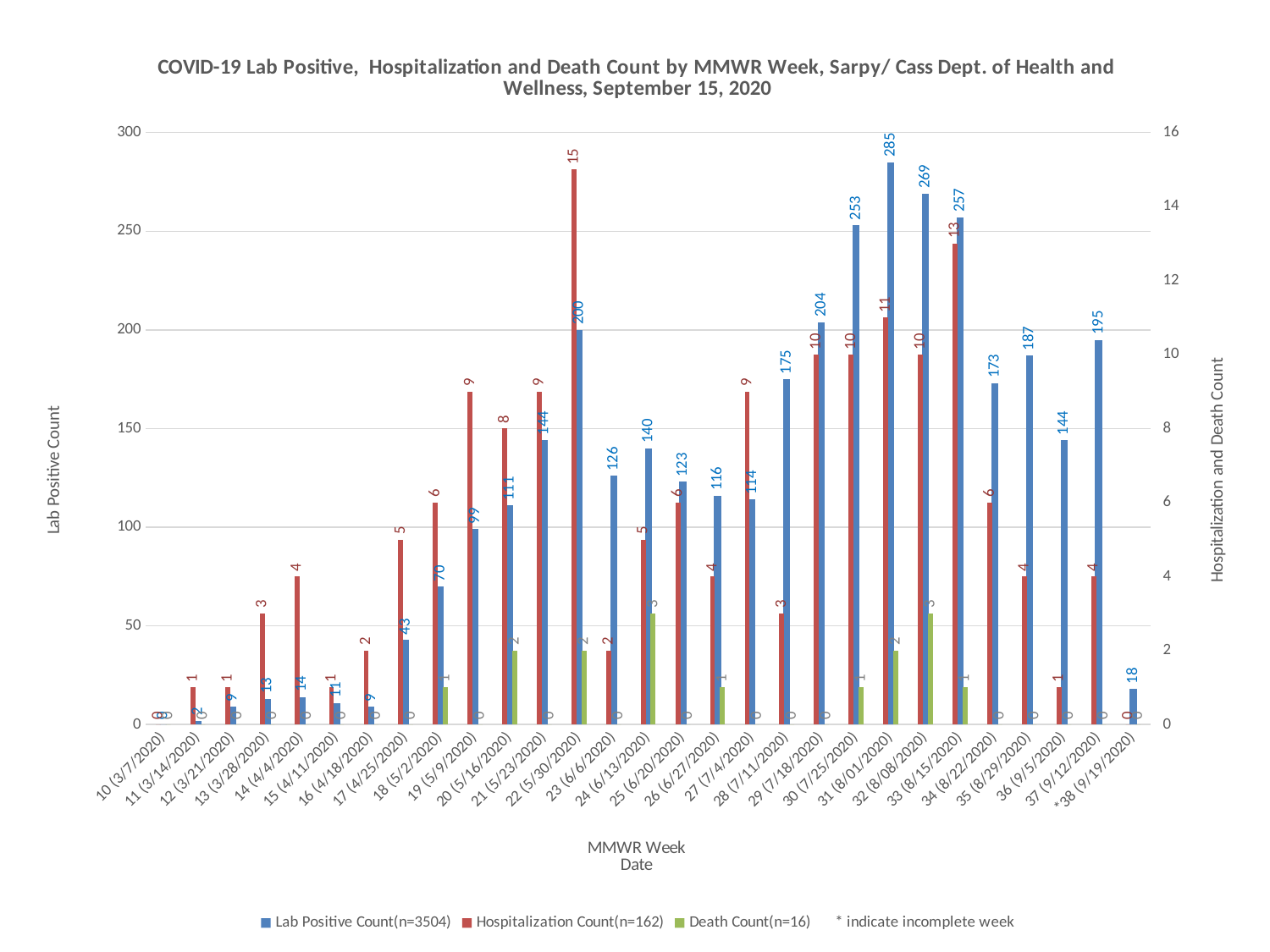
What is the Hospitalization Count for MMWR week 22 (5/30/2020)? 15 How many MMWR weeks are shown on the x axis? 29 What does the asterisk on MMWR week 38 indicate, according to the legend note? Incomplete week What is the Lab Positive Count for MMWR week 31 (8/01/2020)? 285 What is the difference in Lab Positive Count between MMWR week 31 (8/01/2020) and MMWR week 32 (8/08/2020)? 16 Which MMWR week has the highest Lab Positive Count? 31 (8/01/2020) What is the Death Count for MMWR week 32 (8/08/2020)? 3 Which is larger, the Lab Positive Count for MMWR week 29 (7/18/2020) or for MMWR week 37 (9/12/2020)? 29 (7/18/2020) How many series does the legend list? 3 Which MMWR week has the highest Hospitalization Count? 22 (5/30/2020) Is the Lab Positive Count for MMWR week 30 (7/25/2020) greater or less than 250? greater What kind of chart is shown on the slide? Bar chart